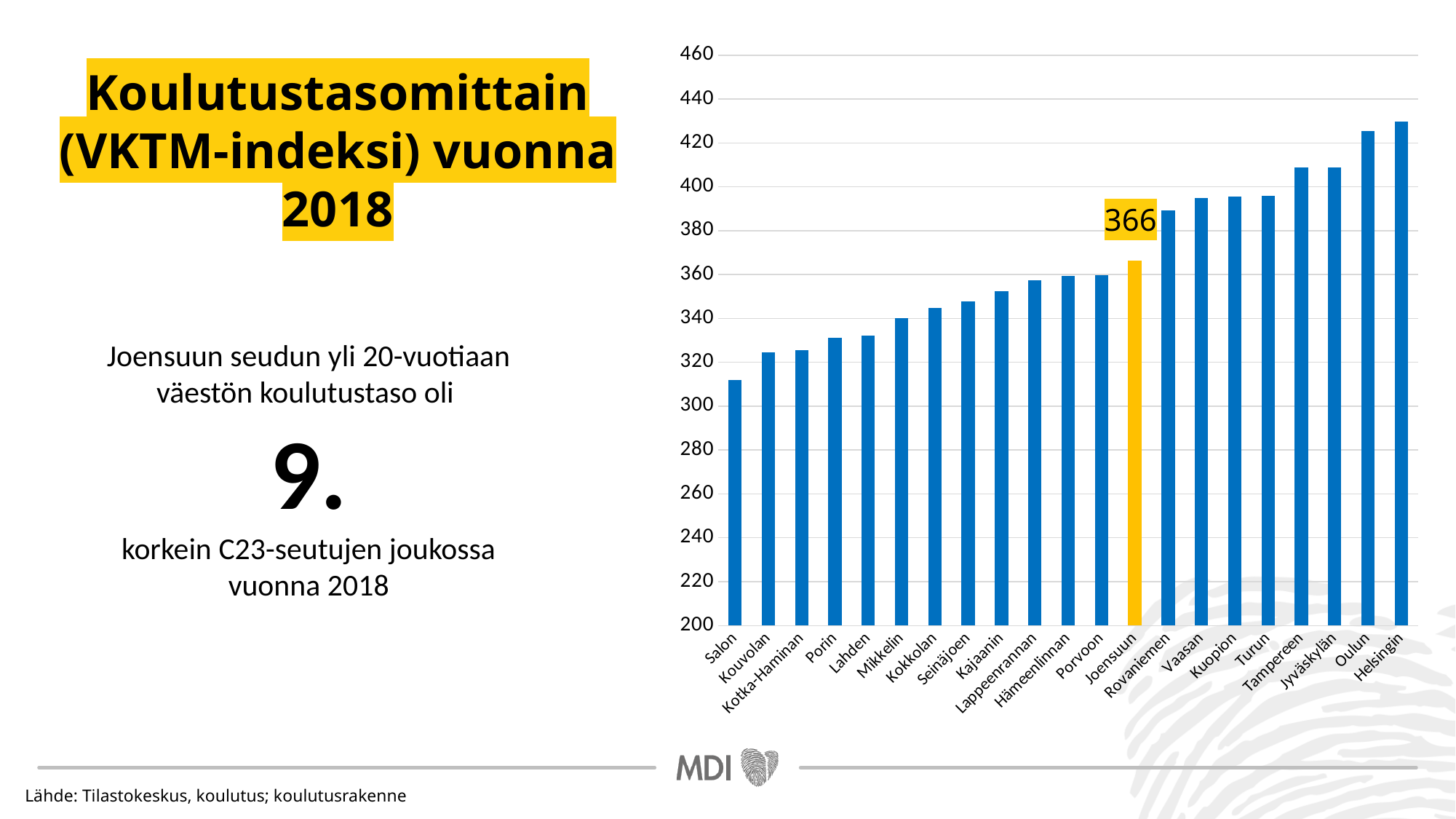
Do the bar values rise or fall from left to right along the x axis? rise Which region has the highest bar in the chart? Helsingin What is the VKTM index value shown for Joensuun? 366 Is the value for Salon greater or less than 320? less Which bar is highlighted in yellow in the chart? Joensuun How many regions (bars) are shown in the chart? 21 Which region has the lowest bar in the chart? Salon Which has a higher value, Oulun or Tampereen? Oulun Is the value for Rovaniemen greater or less than 400? less What type of chart is shown on the slide? bar chart Is the value for Tampereen greater or less than 400? greater